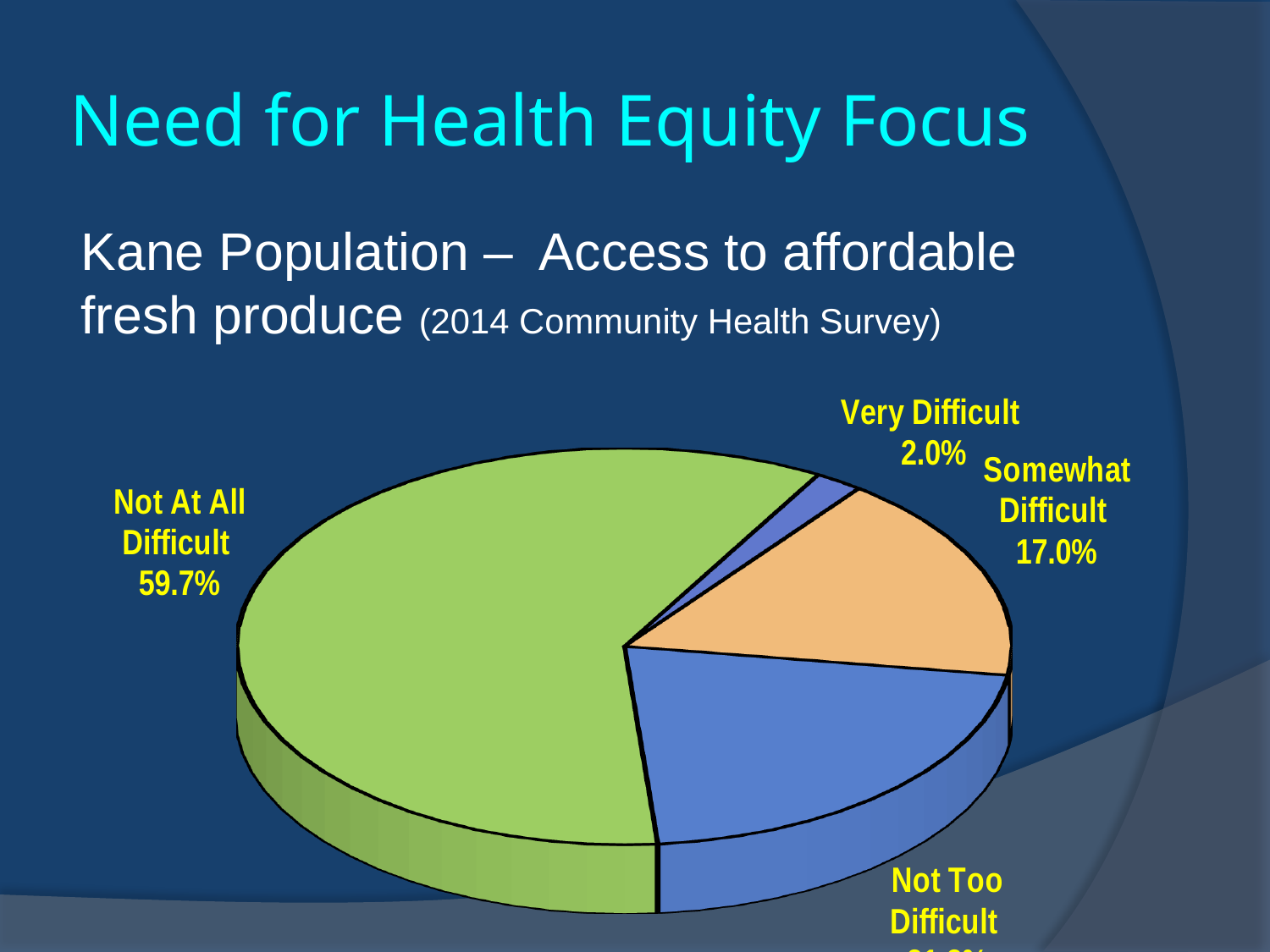
What share of the pie does the Not At All Difficult slice represent? 59.7% Which is larger, the Somewhat Difficult slice or the Very Difficult slice? Somewhat Difficult How many slices does the pie chart have? 4 What is the difference in percentage points between Not At All Difficult and Somewhat Difficult? 42.7 Which is larger, the Not At All Difficult slice or the Not Too Difficult slice? Not At All Difficult What colour is the Not At All Difficult slice? green What kind of chart is shown on the slide? pie chart What is the value shown for Very Difficult? 2.0% Which category has the smallest slice of the pie? Very Difficult What is the value shown for Somewhat Difficult? 17.0% Which category has the largest slice of the pie? Not At All Difficult What is the difference in percentage points between Somewhat Difficult and Very Difficult? 15.0